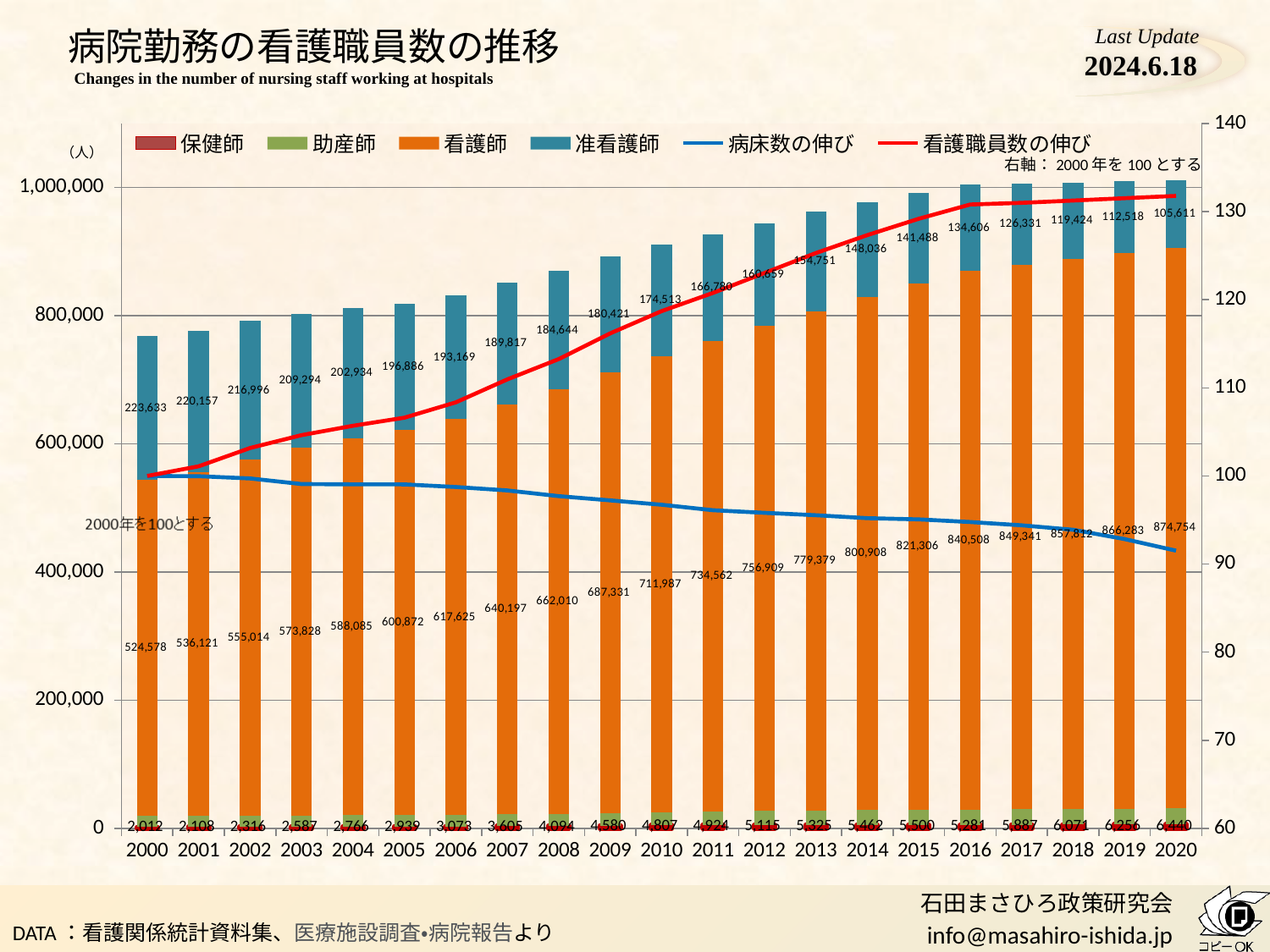
What is the difference between the 看護師 value in 2020 and in 2000? 350,176 How many series does the legend list? 6 In which year is the value for 准看護師 lowest? 2020 Is the value of the 病床数の伸び line in 2020 greater or less than 100 on the right axis? less What is the value for 看護師 in 2010? 711,987 What is the value for 准看護師 in 2000? 223,633 What is the value for 看護師 in 2020? 874,754 How many years are shown on the x axis? 21 In which year is the value for 看護師 highest? 2020 Does the value for 准看護師 rise or fall from 2000 to 2020? fall What is the difference between the 准看護師 value in 2000 and in 2020? 118,022 What kind of chart is shown on the slide? combination bar and line chart (stacked bars with two lines)